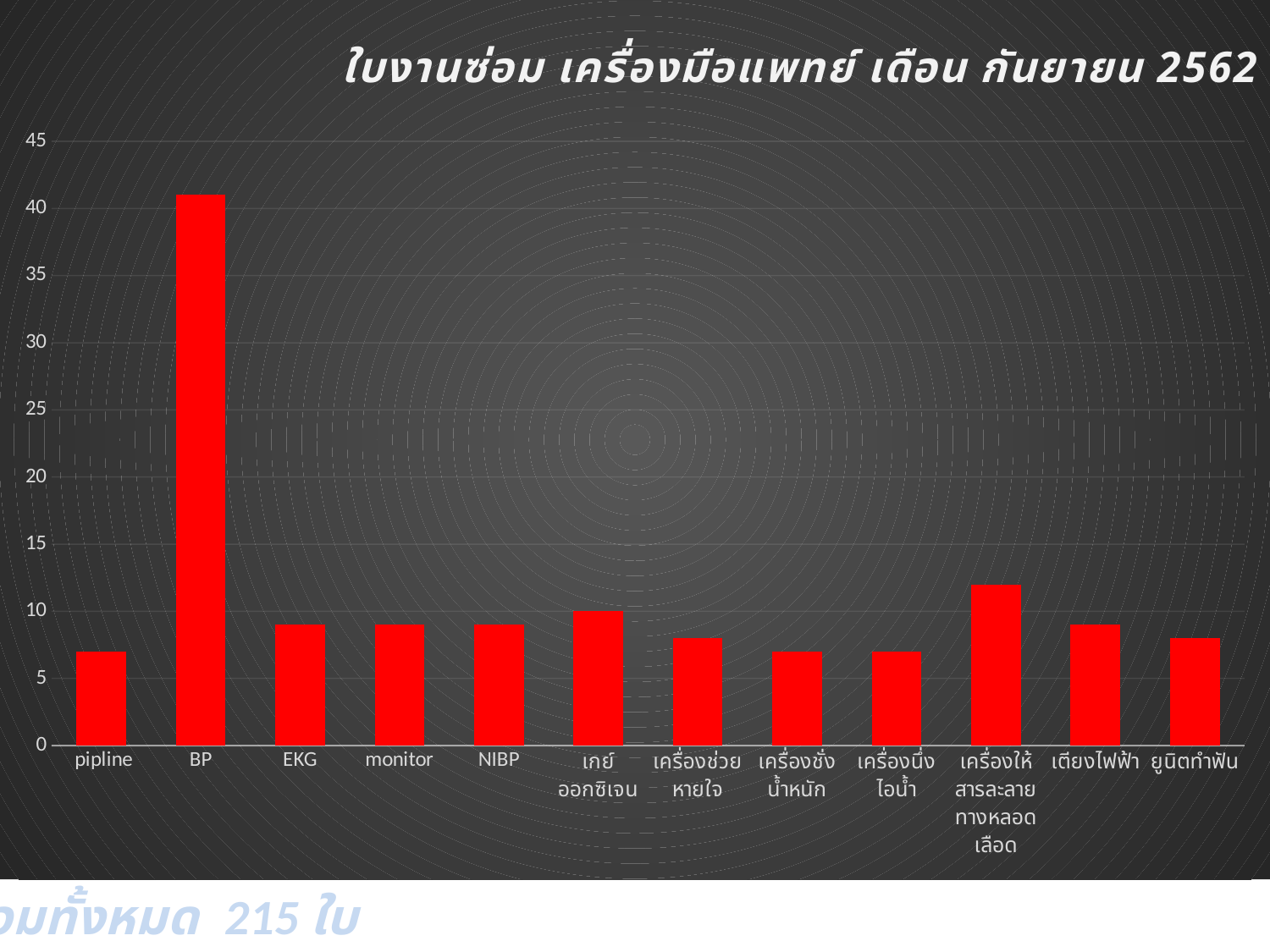
Is the value for pipline greater or less than 10? less Is the value for เครื่องนึ่งไอน้ำ greater or less than 5? greater How many categories are shown on the x axis of the chart? 12 What colour are the bars in the chart? red Which category has the highest value in the chart? BP Which is larger, the value for เครื่องให้สารละลายทางหลอดเลือด or the value for เตียงไฟฟ้า? เครื่องให้สารละลายทางหลอดเลือด What kind of chart is shown on the slide? bar chart Is the value for BP greater or less than 35? greater What is the title of the chart? ใบงานซ่อม เครื่องมือแพทย์ เดือน กันยายน 2562 Which is larger, the value for BP or the value for monitor? BP